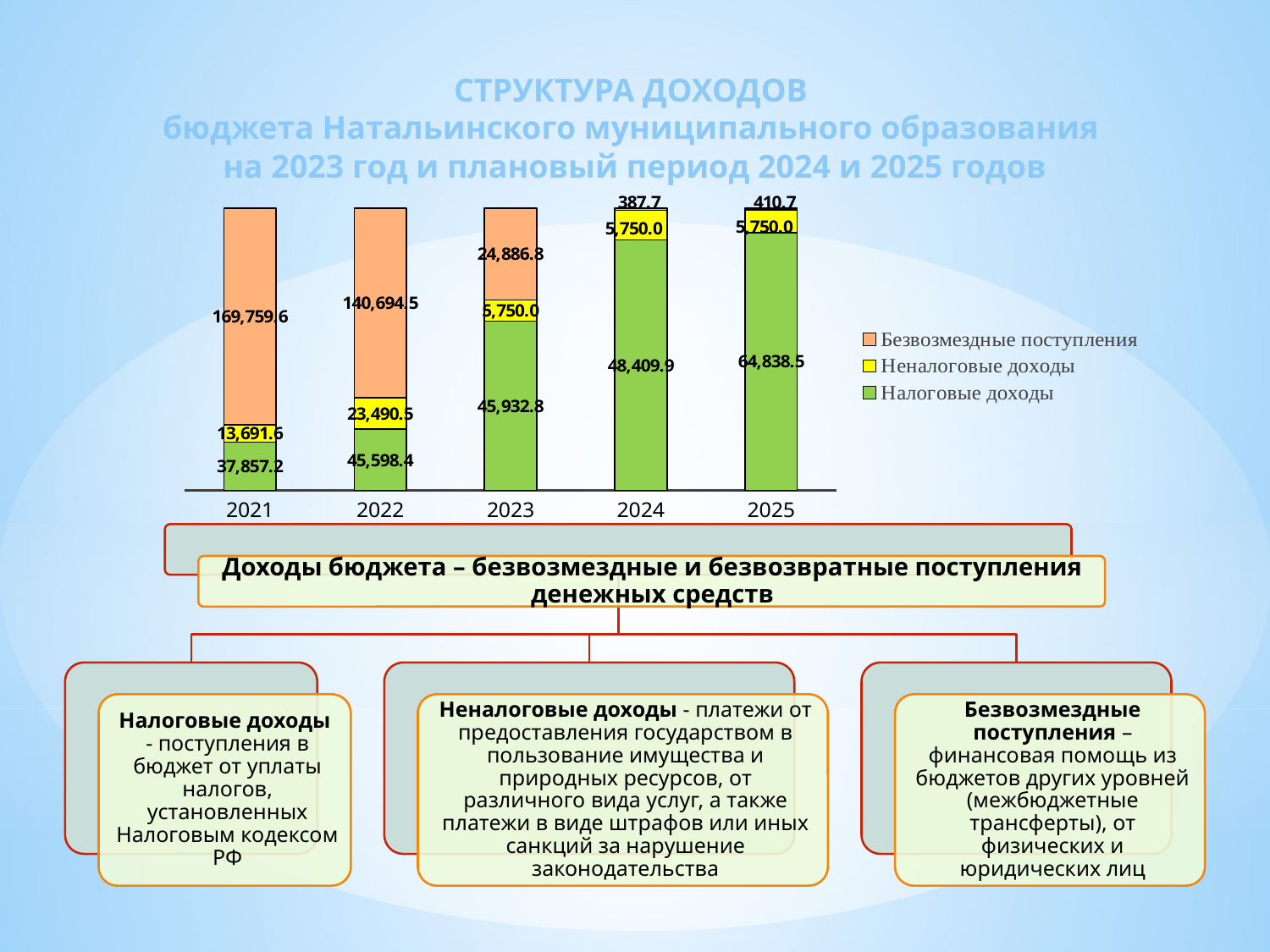
What is the value of Безвозмездные поступления for 2024? 387.7 What is the value of Налоговые доходы for 2025? 64,838.5 What is the difference between Налоговые доходы in 2025 and in 2024? 16,428.6 Do the values of Безвозмездные поступления rise or fall from 2021 to 2025? Fall (though 2025 is slightly higher than 2024) What is the value of Безвозмездные поступления for 2021? 169,759.6 Which is larger: Безвозмездные поступления in 2021 or in 2022? 2021 How many years are shown on the x axis? 5 What kind of chart is shown on the slide? Stacked bar chart In which year is Налоговые доходы the highest? 2025 What is the value of Неналоговые доходы for 2022? 23,490.5 How many series does the legend list? 3 In which year is Безвозмездные поступления the lowest? 2024